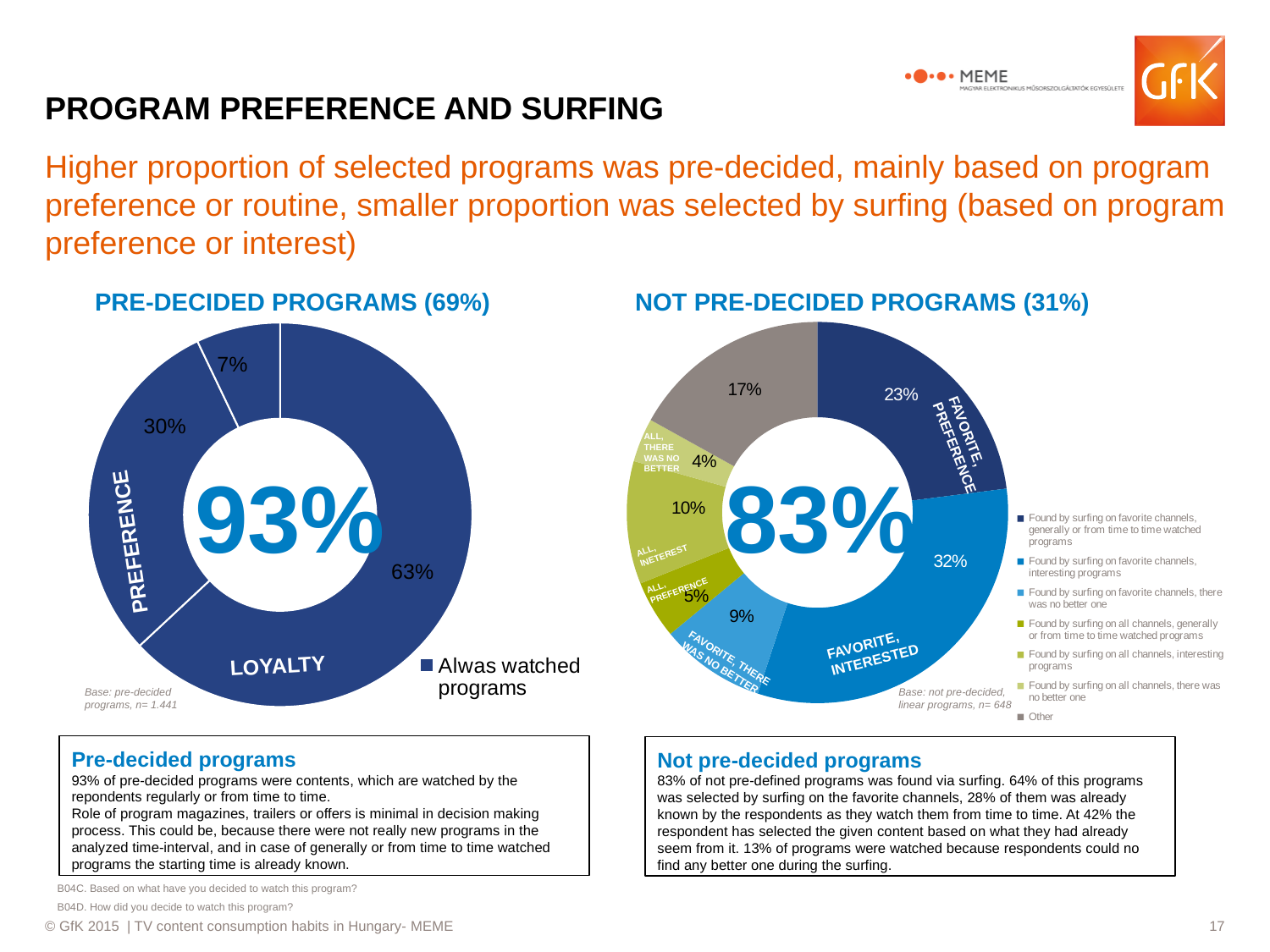
In the PRE-DECIDED PROGRAMS chart, which is larger, the LOYALTY slice or the PREFERENCE slice? LOYALTY In the NOT PRE-DECIDED PROGRAMS chart, which slice is the largest? Favorite, interested (32%) In the NOT PRE-DECIDED PROGRAMS chart, what is the difference between the 'Favorite, interested' slice and the 'Favorite, preference' slice? 9 percentage points How many slices does the PRE-DECIDED PROGRAMS chart have? 3 In the NOT PRE-DECIDED PROGRAMS chart, what percentage is shown for the 'Favorite, preference' slice? 23% How many entries does the legend of the NOT PRE-DECIDED PROGRAMS chart list? 7 In the PRE-DECIDED PROGRAMS chart, what percentage is shown for the LOYALTY slice? 63% What kind of chart is used for the PRE-DECIDED PROGRAMS data? Doughnut (pie) chart In the NOT PRE-DECIDED PROGRAMS chart, what percentage is shown for the 'Favorite, interested' slice? 32% In the NOT PRE-DECIDED PROGRAMS chart, which slice is the smallest? All, there was no better (4%) In the PRE-DECIDED PROGRAMS chart, what percentage is shown for the PREFERENCE slice? 30% What large percentage is printed in the centre of the NOT PRE-DECIDED PROGRAMS chart? 83%